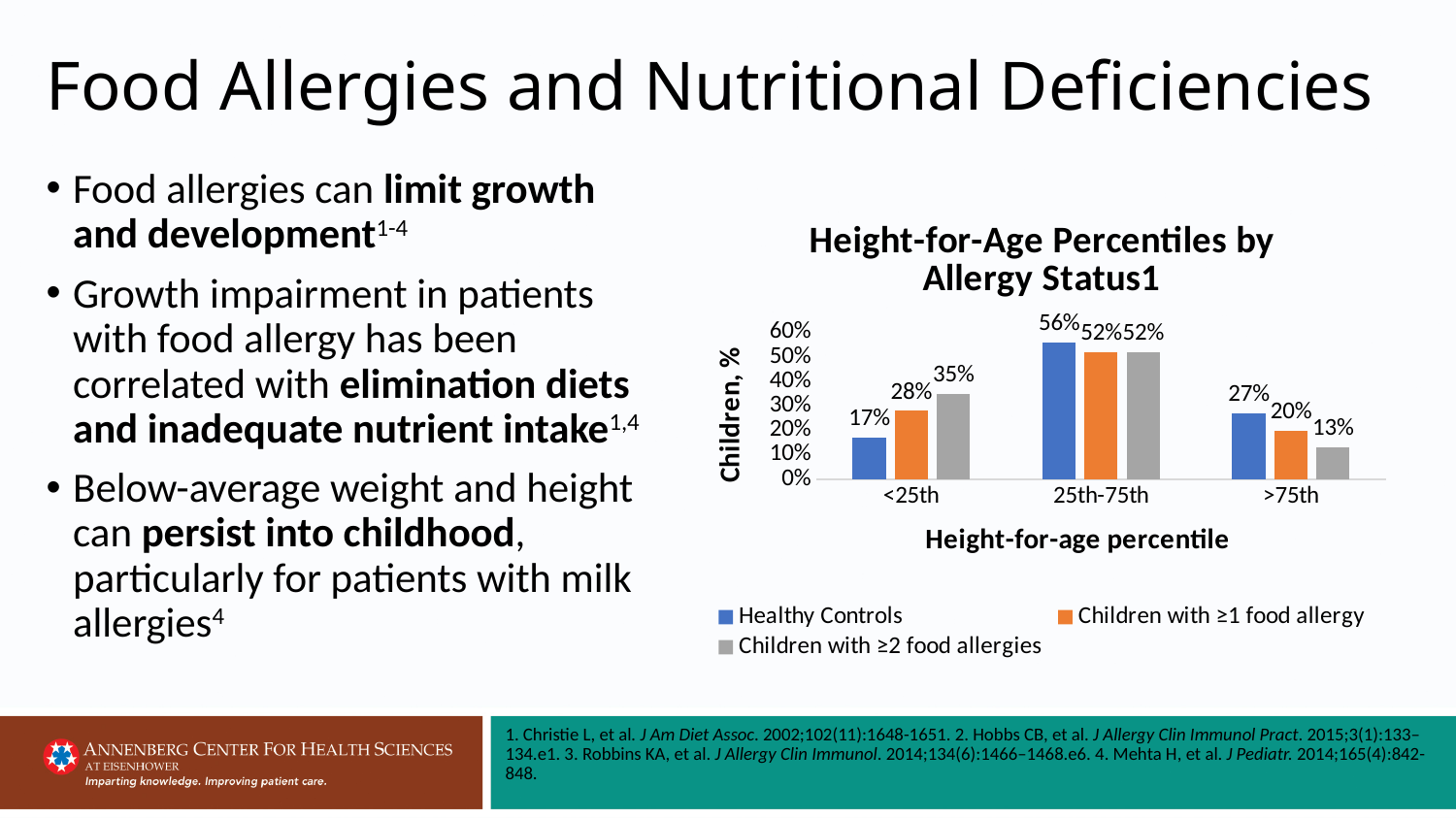
What is the value for Children with ≥1 food allergy in the 25th-75th percentile category? 52% Which height-for-age percentile category has the lowest value for Children with ≥2 food allergies? >75th Is the value for Healthy Controls in the 25th-75th percentile category greater or less than 50%? greater What is the value for Children with ≥2 food allergies in the >75th percentile category? 13% In the >75th percentile category, which is larger: Healthy Controls or Children with ≥1 food allergy? Healthy Controls Which height-for-age percentile category has the highest value for Healthy Controls? 25th-75th How many series does the legend list? 3 What kind of chart is shown on the slide? Bar chart What is the label of the y axis of the chart? Children, % How many height-for-age percentile categories are shown on the x axis? 3 What is the difference between Children with ≥2 food allergies and Healthy Controls in the <25th percentile category? 18% What is the value for Healthy Controls in the <25th height-for-age percentile category? 17%